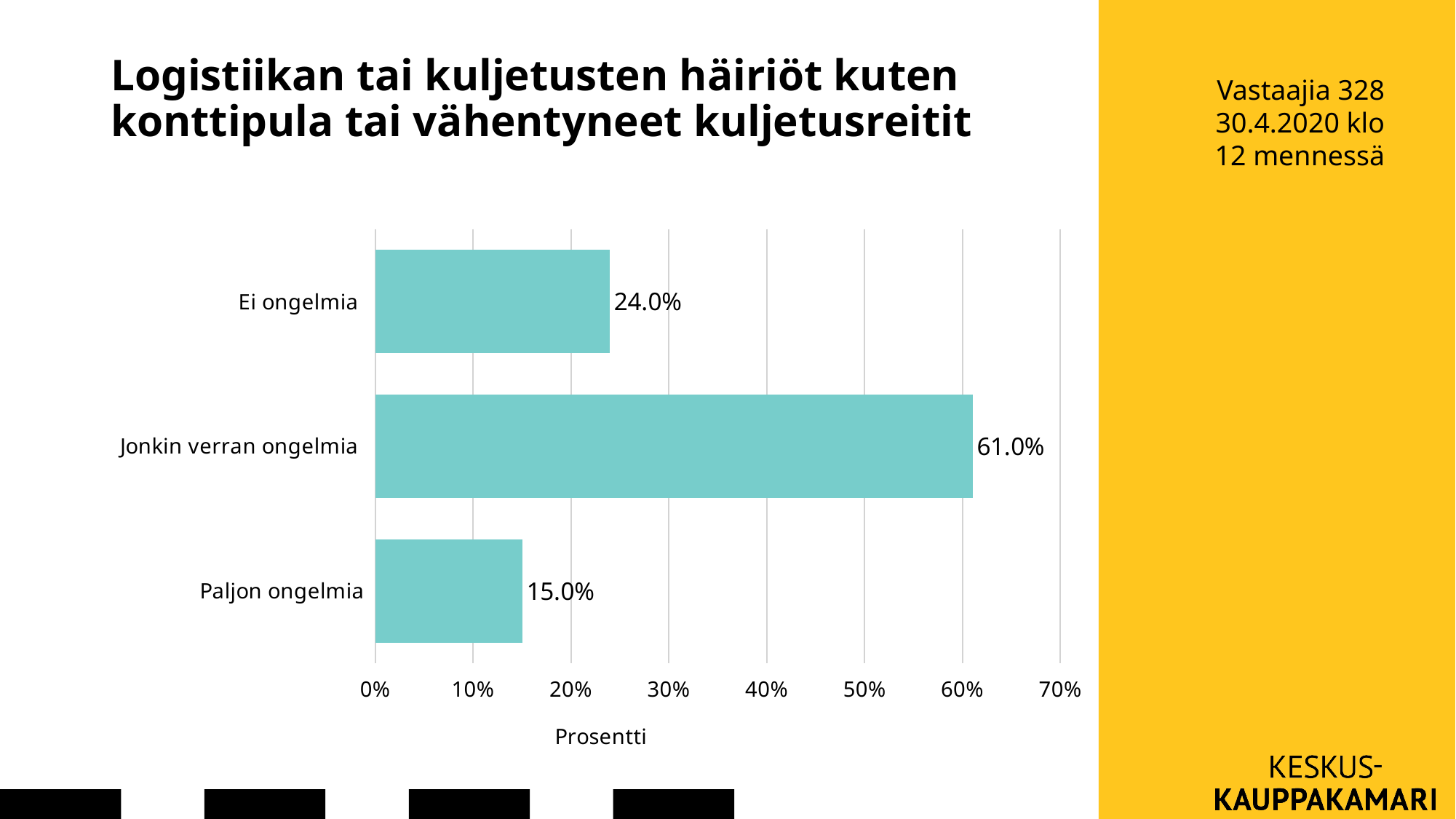
What is the value for "Jonkin verran ongelmia"? 61.0% Which is larger, the value for "Ei ongelmia" or the value for "Paljon ongelmia"? Ei ongelmia How many categories are shown in the chart? 3 What is the label of the horizontal axis? Prosentti Which category has the lowest value? Paljon ongelmia What is the value for "Ei ongelmia"? 24.0% What is the difference between the values for "Jonkin verran ongelmia" and "Ei ongelmia"? 37.0% Which category has the highest value? Jonkin verran ongelmia What is the difference between the values for "Ei ongelmia" and "Paljon ongelmia"? 9.0% What is the value for "Paljon ongelmia"? 15.0% Is the value for "Jonkin verran ongelmia" greater or less than 50%? greater What kind of chart is shown on the slide? Bar chart